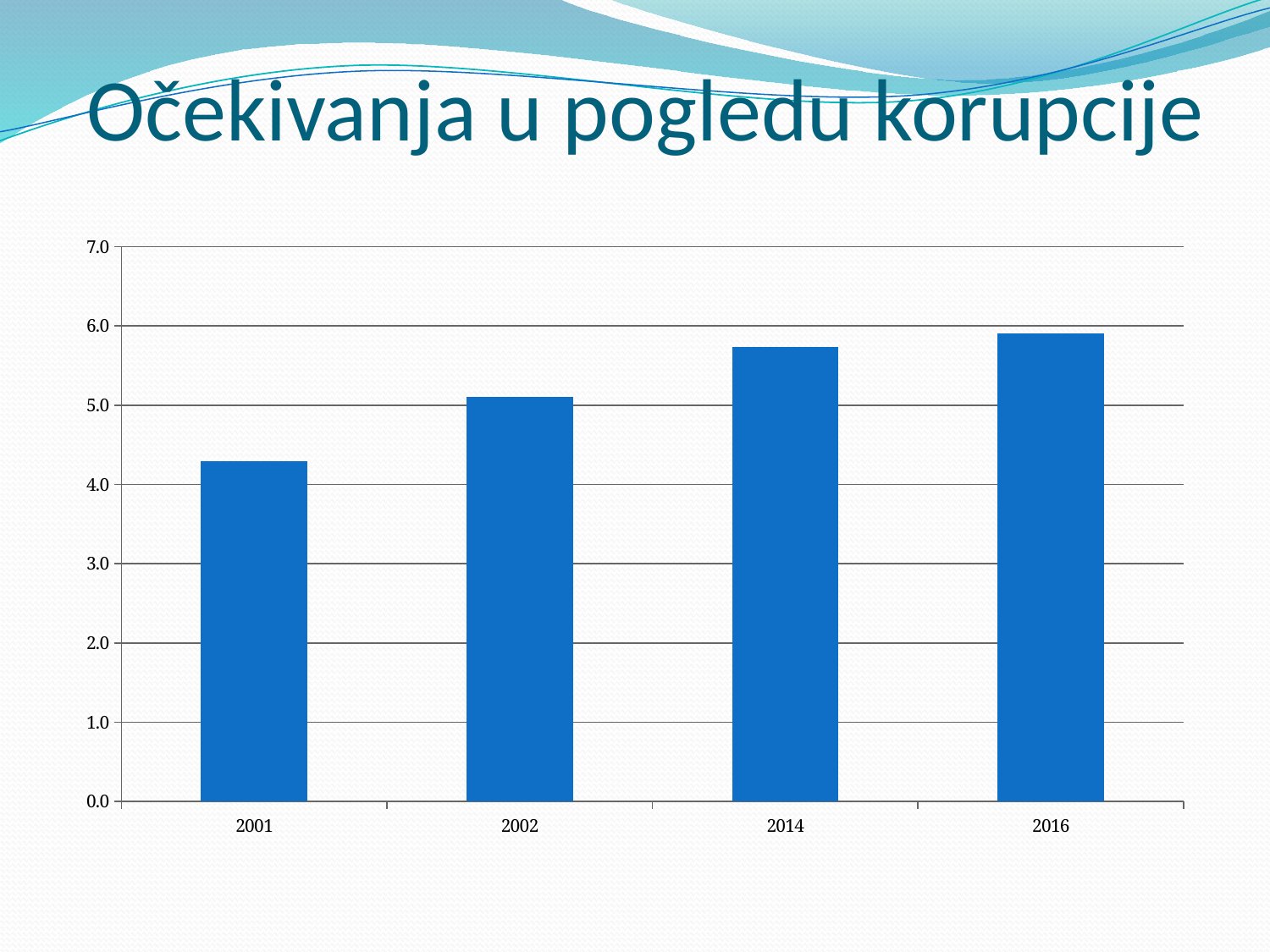
How many bars (years) are shown in the chart? 4 Is the value for 2016 greater or less than 6.0? less What kind of chart is shown on the slide? bar chart Is the value for 2002 greater or less than 6.0? less Is the value for 2014 greater or less than 5.0? greater Which is larger, the value for 2002 or the value for 2014? 2014 Which year has the lowest value in the chart? 2001 Which is larger, the value for 2001 or the value for 2002? 2002 What is the title of the slide containing the chart? Očekivanja u pogledu korupcije Do the values rise or fall from 2001 to 2016? rise